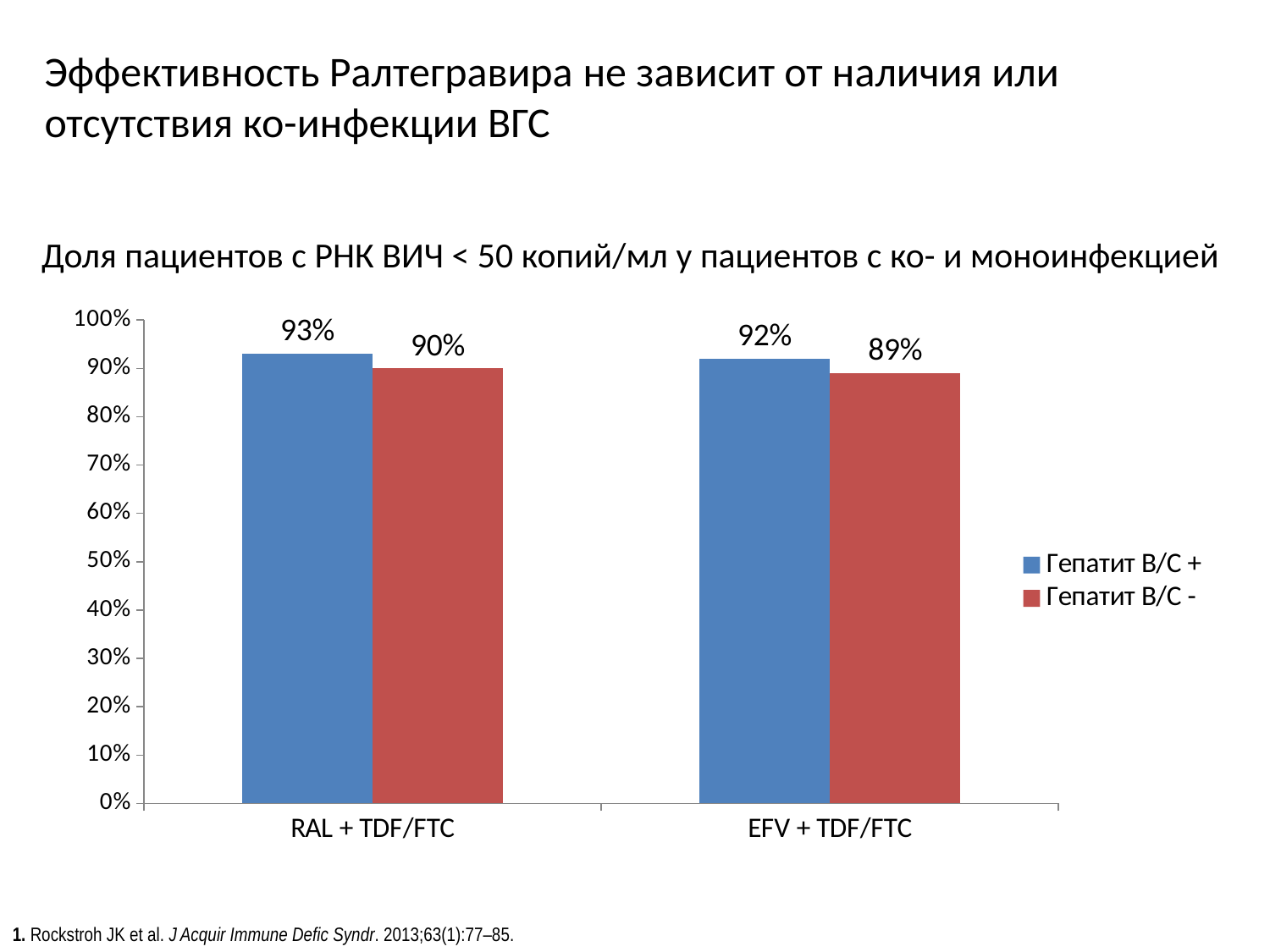
What is the value for Гепатит B/C + in the EFV + TDF/FTC group? 92% What is the value for Гепатит B/C + in the RAL + TDF/FTC group? 93% Which bar has the lowest value on the chart? Гепатит B/C - in EFV + TDF/FTC (89%) What is the difference between the Гепатит B/C + and Гепатит B/C - values in the RAL + TDF/FTC group? 3% Which colour represents the Гепатит B/C - series? Red What is the difference between the Гепатит B/C + values for RAL + TDF/FTC and EFV + TDF/FTC? 1% How many series does the legend list? 2 Which bar has the highest value on the chart? Гепатит B/C + in RAL + TDF/FTC (93%) How many categories are shown on the x axis? 2 What is the value for Гепатит B/C - in the RAL + TDF/FTC group? 90% What is the value for Гепатит B/C - in the EFV + TDF/FTC group? 89% What kind of chart is shown on the slide? Bar chart